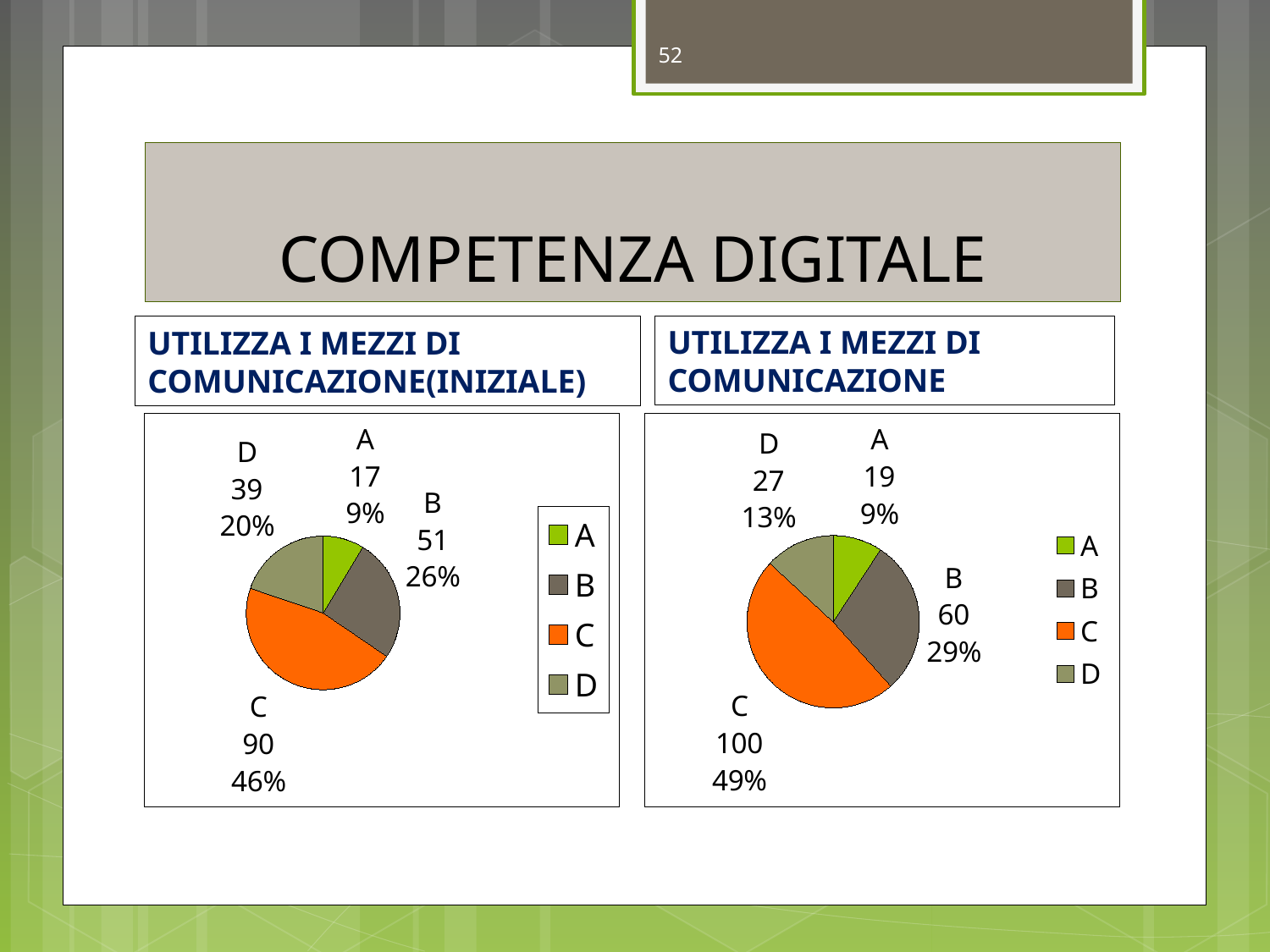
In the chart titled 'UTILIZZA I MEZZI DI COMUNICAZIONE' (right), which category has the lowest value? A In the chart titled 'UTILIZZA I MEZZI DI COMUNICAZIONE' (right), what is the value for category B? 60 In the chart titled 'UTILIZZA I MEZZI DI COMUNICAZIONE(INIZIALE)', what is the difference between the values for C and B? 39 In the chart titled 'UTILIZZA I MEZZI DI COMUNICAZIONE' (right), what is the difference between the values for B and D? 33 How many categories are shown in the chart titled 'UTILIZZA I MEZZI DI COMUNICAZIONE(INIZIALE)'? 4 In the chart titled 'UTILIZZA I MEZZI DI COMUNICAZIONE(INIZIALE)', which category has the highest value? C In the chart titled 'UTILIZZA I MEZZI DI COMUNICAZIONE(INIZIALE)', what percentage share does category D have? 20% In the chart titled 'UTILIZZA I MEZZI DI COMUNICAZIONE' (right), which is larger, the value for B or the value for D? B In the chart titled 'UTILIZZA I MEZZI DI COMUNICAZIONE' (right), what percentage share does category C have? 49% In the chart titled 'UTILIZZA I MEZZI DI COMUNICAZIONE(INIZIALE)', what is the value for category C? 90 What kind of chart is the chart titled 'UTILIZZA I MEZZI DI COMUNICAZIONE' (right)? Pie chart In the chart titled 'UTILIZZA I MEZZI DI COMUNICAZIONE(INIZIALE)', what colour is the slice for category C? Orange